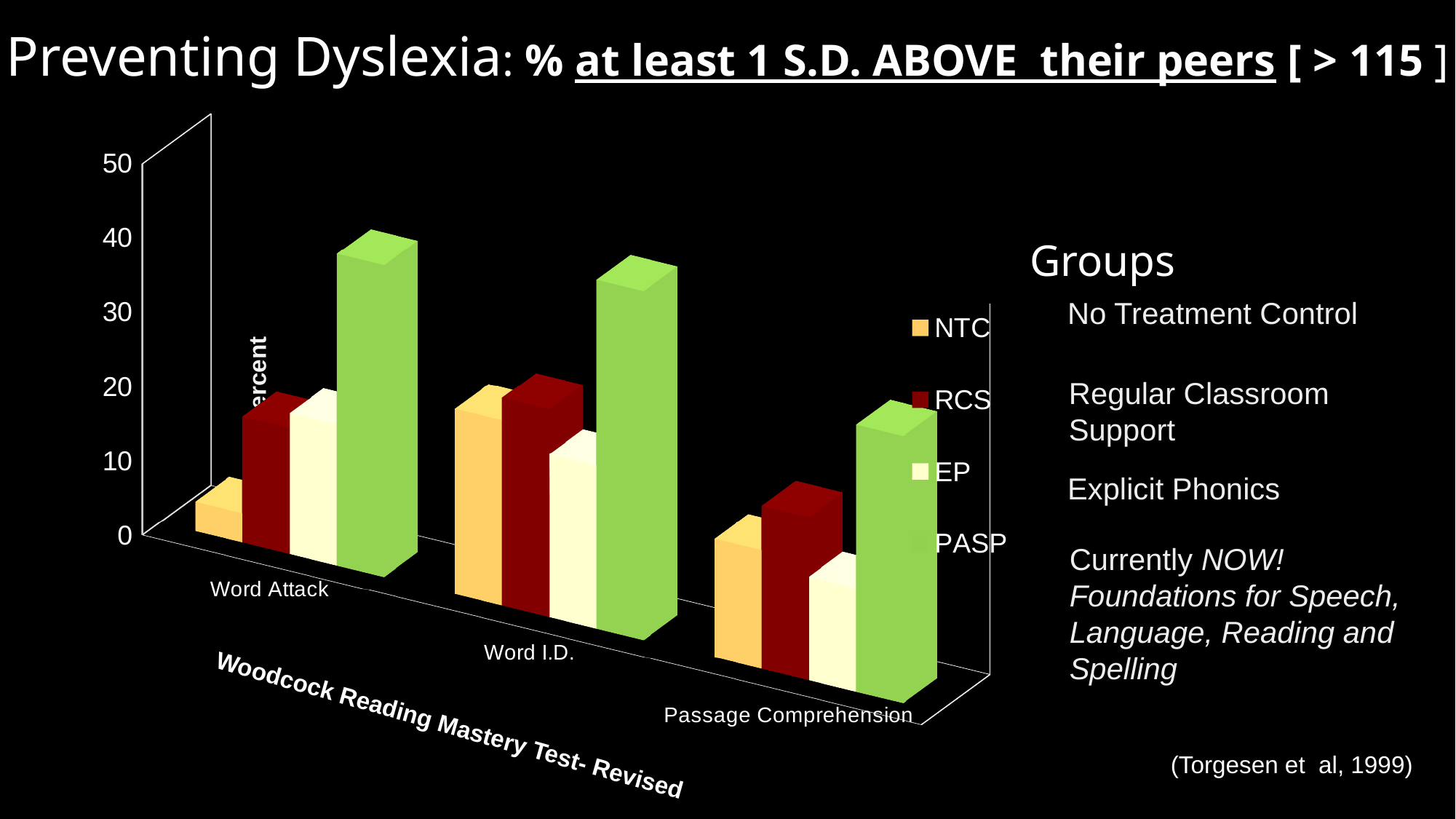
Is the PASP value for Word Attack greater or less than 30? greater How many categories are shown on the x axis of the chart? 3 Which group has the highest bar for Word Attack? PASP What kind of chart is shown on the slide? bar chart Which group has the lowest bar for Passage Comprehension? EP How many series does the chart's legend list? 4 What is the title of the chart's x axis? Woodcock Reading Mastery Test- Revised Is the NTC value for Word Attack greater or less than 10? less Which is larger: the NTC value for Word Attack or the NTC value for Word I.D.? Word I.D. Which group has the lowest bar for Word Attack? NTC Which group has the highest bar for Passage Comprehension? PASP